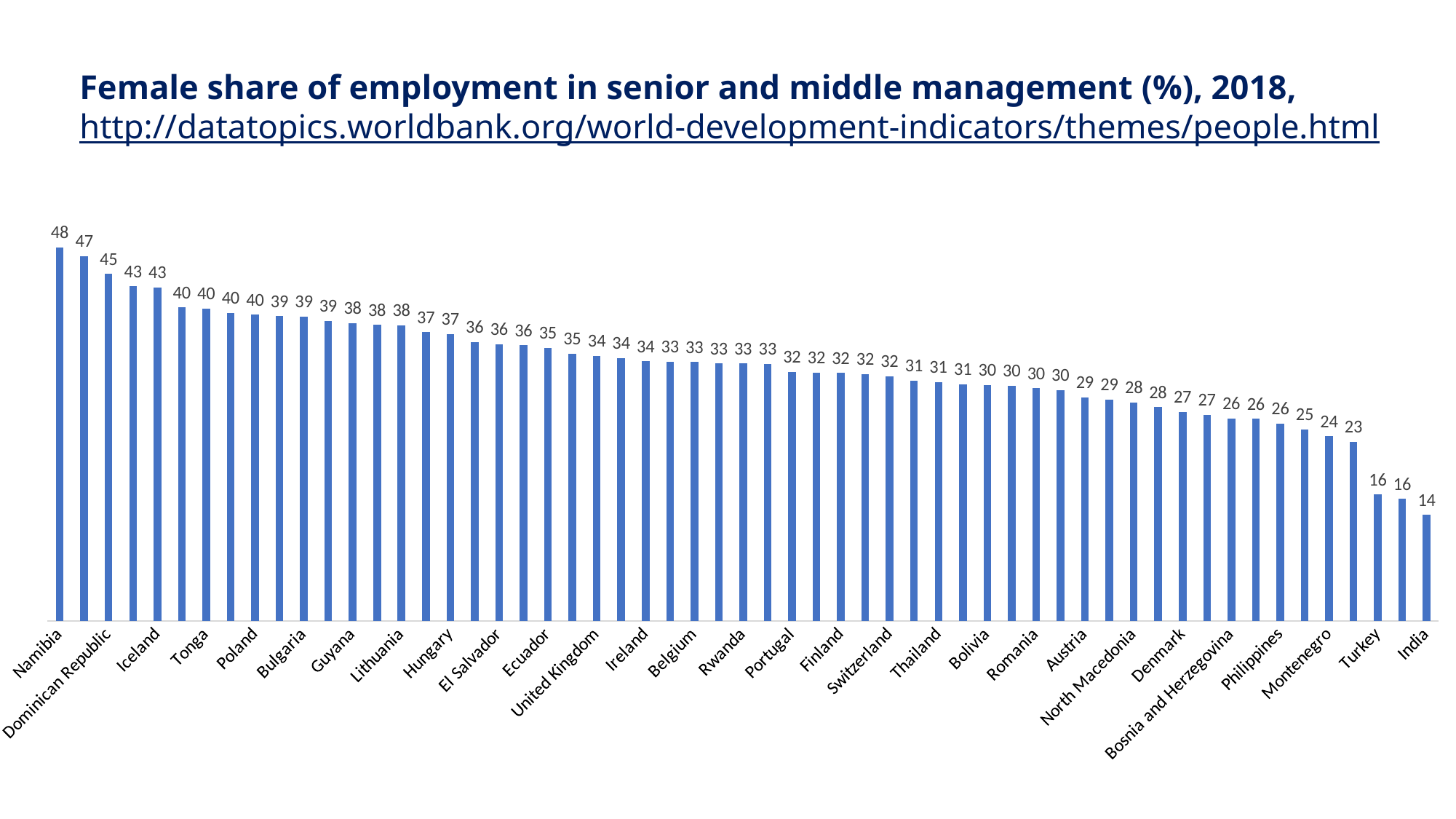
What is the value for Namibia? 48 What year does the chart title say the data is for? 2018 What kind of chart is shown on the slide? bar chart Which country has the lowest female share of employment in senior and middle management? India Which is larger, the value for Iceland or the value for Turkey? Iceland What is the value for Hungary? 37 Do the values rise or fall from left to right along the x axis? fall What is the value for Iceland? 43 What is the difference between the values for Namibia and India? 34 What is the value for Turkey? 16 What is the value for India? 14 Which country has the highest female share of employment in senior and middle management? Namibia